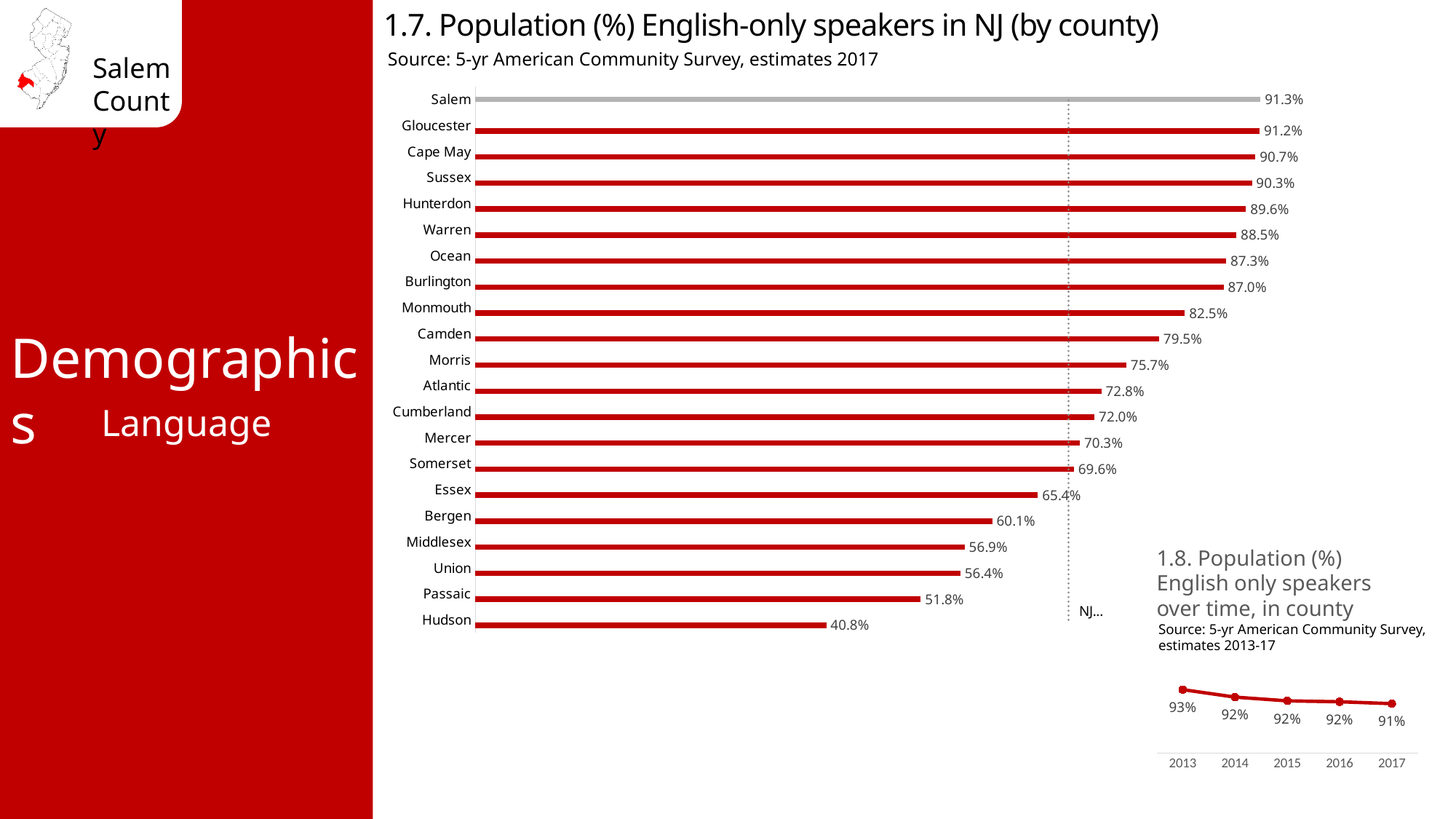
In the chart '1.7. Population (%) English-only speakers in NJ (by county)', which county has the lowest value? Hudson In the chart '1.7. Population (%) English-only speakers in NJ (by county)', what is the difference between Gloucester and Cape May? 0.5 percentage points In the chart '1.7. Population (%) English-only speakers in NJ (by county)', which is larger, Camden or Morris? Camden In the chart '1.8. Population (%) English only speakers over time, in county', do the values rise or fall from 2013 to 2017? Fall What kind of chart is '1.7. Population (%) English-only speakers in NJ (by county)'? Bar chart In the chart '1.7. Population (%) English-only speakers in NJ (by county)', how many counties are shown? 21 In the chart '1.8. Population (%) English only speakers over time, in county', what is the value for 2013? 93% In the chart '1.7. Population (%) English-only speakers in NJ (by county)', what is the difference between Salem and Hudson? 50.5 percentage points In the chart '1.7. Population (%) English-only speakers in NJ (by county)', what is the value for Cumberland? 72.0% In the chart '1.7. Population (%) English-only speakers in NJ (by county)', what is the value for Salem? 91.3% What kind of chart is '1.8. Population (%) English only speakers over time, in county'? Line chart In the chart '1.7. Population (%) English-only speakers in NJ (by county)', what is the value for Hudson? 40.8%